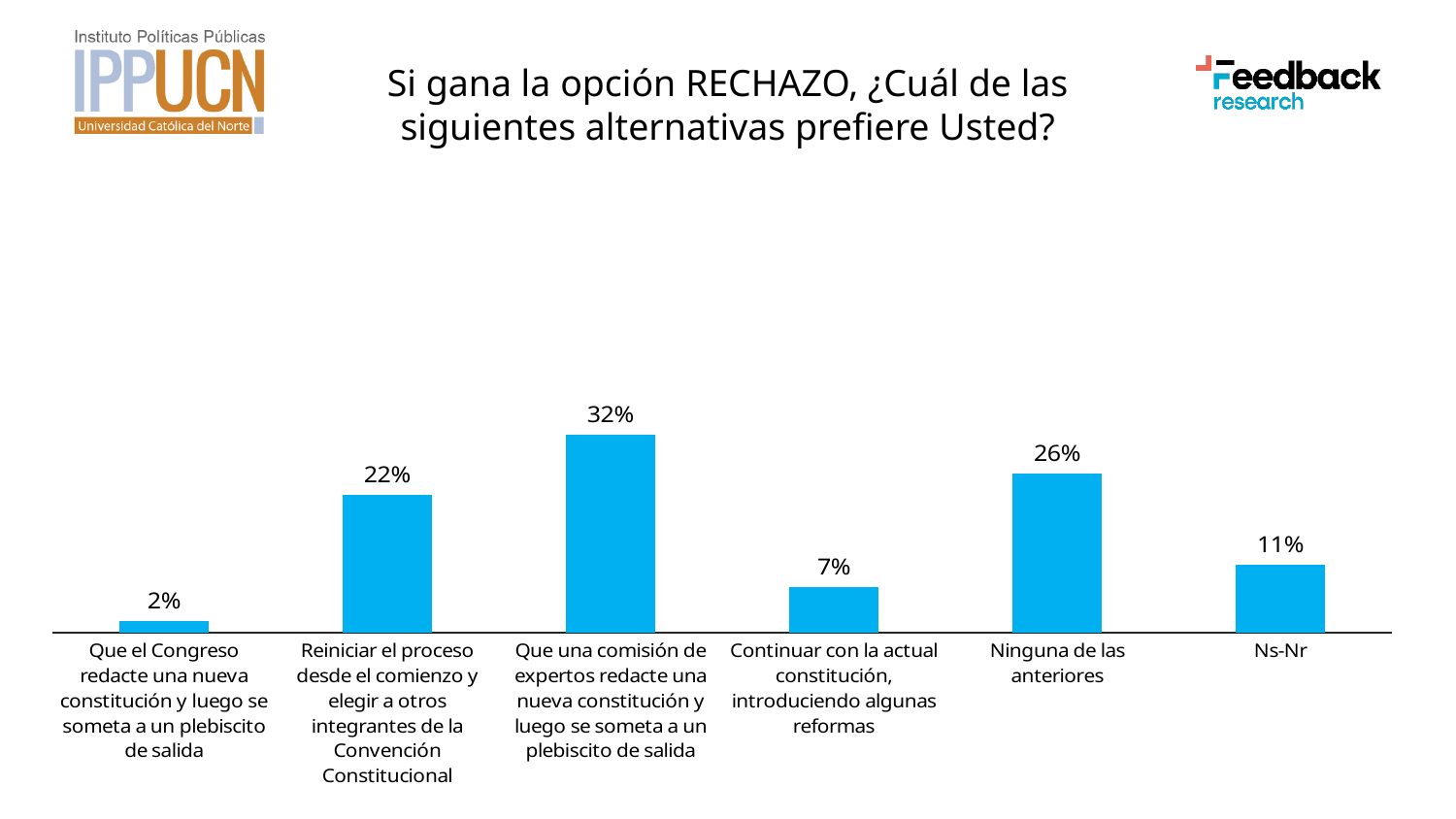
What kind of chart is shown on the slide? Bar chart What is the value for 'Ns-Nr'? 11% What is the value for 'Ninguna de las anteriores'? 26% What is the difference between the value for 'Ns-Nr' and the value for 'Continuar con la actual constitución, introduciendo algunas reformas'? 4% Which alternative has the highest percentage? Que una comisión de expertos redacte una nueva constitución y luego se someta a un plebiscito de salida Which alternative has the lowest percentage? Que el Congreso redacte una nueva constitución y luego se someta a un plebiscito de salida What is the difference between the value for the expert commission option and the value for restarting the process with a new Convention? 10% What question is the chart answering, according to the slide title? Si gana la opción RECHAZO, ¿Cuál de las siguientes alternativas prefiere Usted? What percentage of respondents prefer that a commission of experts draft a new constitution and then submit it to an exit plebiscite? 32% How many categories are shown in the chart? 6 What percentage prefer continuing with the current constitution while introducing some reforms? 7% Which is larger: the value for 'Ninguna de las anteriores' or the value for 'Reiniciar el proceso desde el comienzo y elegir a otros integrantes de la Convención Constitucional'? Ninguna de las anteriores